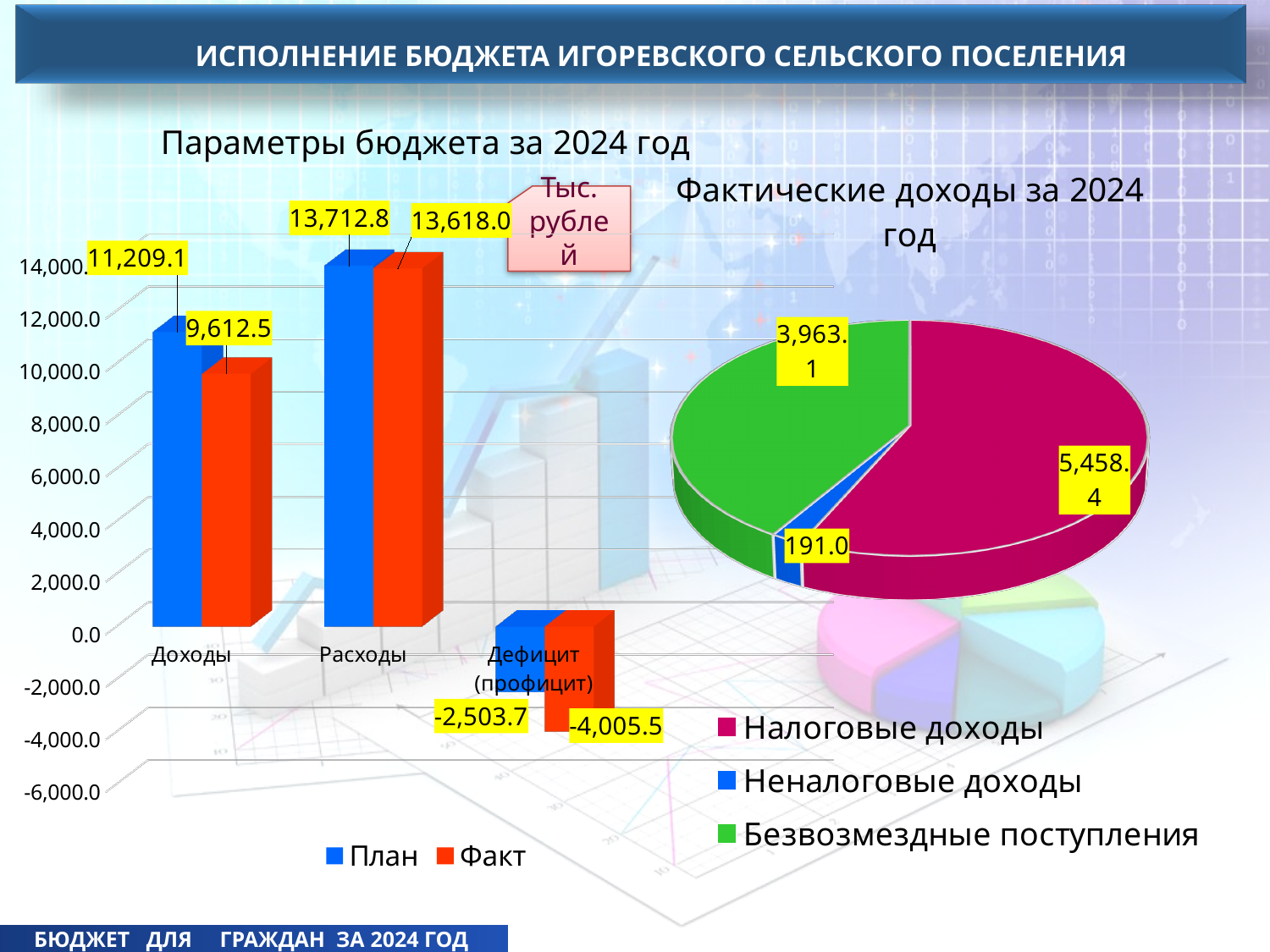
In the bar chart 'Параметры бюджета за 2024 год', which is larger for Расходы: План or Факт? План In the bar chart 'Параметры бюджета за 2024 год', how many categories are shown on the x axis? 3 In the bar chart 'Параметры бюджета за 2024 год', what is the difference between the План and Факт values for Доходы? 1,596.6 In the pie chart 'Фактические доходы за 2024 год', what is the total of all three slices? 9,612.5 What type of chart is 'Фактические доходы за 2024 год'? Pie chart In the bar chart 'Параметры бюджета за 2024 год', what is the Факт value for Дефицит (профицит)? -4,005.5 In the bar chart 'Параметры бюджета за 2024 год', which category has the highest План value? Расходы In the pie chart 'Фактические доходы за 2024 год', what is the value for Налоговые доходы? 5,458.4 In the pie chart 'Фактические доходы за 2024 год', which category has the smallest slice? Неналоговые доходы In the bar chart 'Параметры бюджета за 2024 год', what is the План value for Доходы? 11,209.1 In the bar chart 'Параметры бюджета за 2024 год', what is the Факт value for Расходы? 13,618.0 In the bar chart 'Параметры бюджета за 2024 год', how many series does the legend list? 2